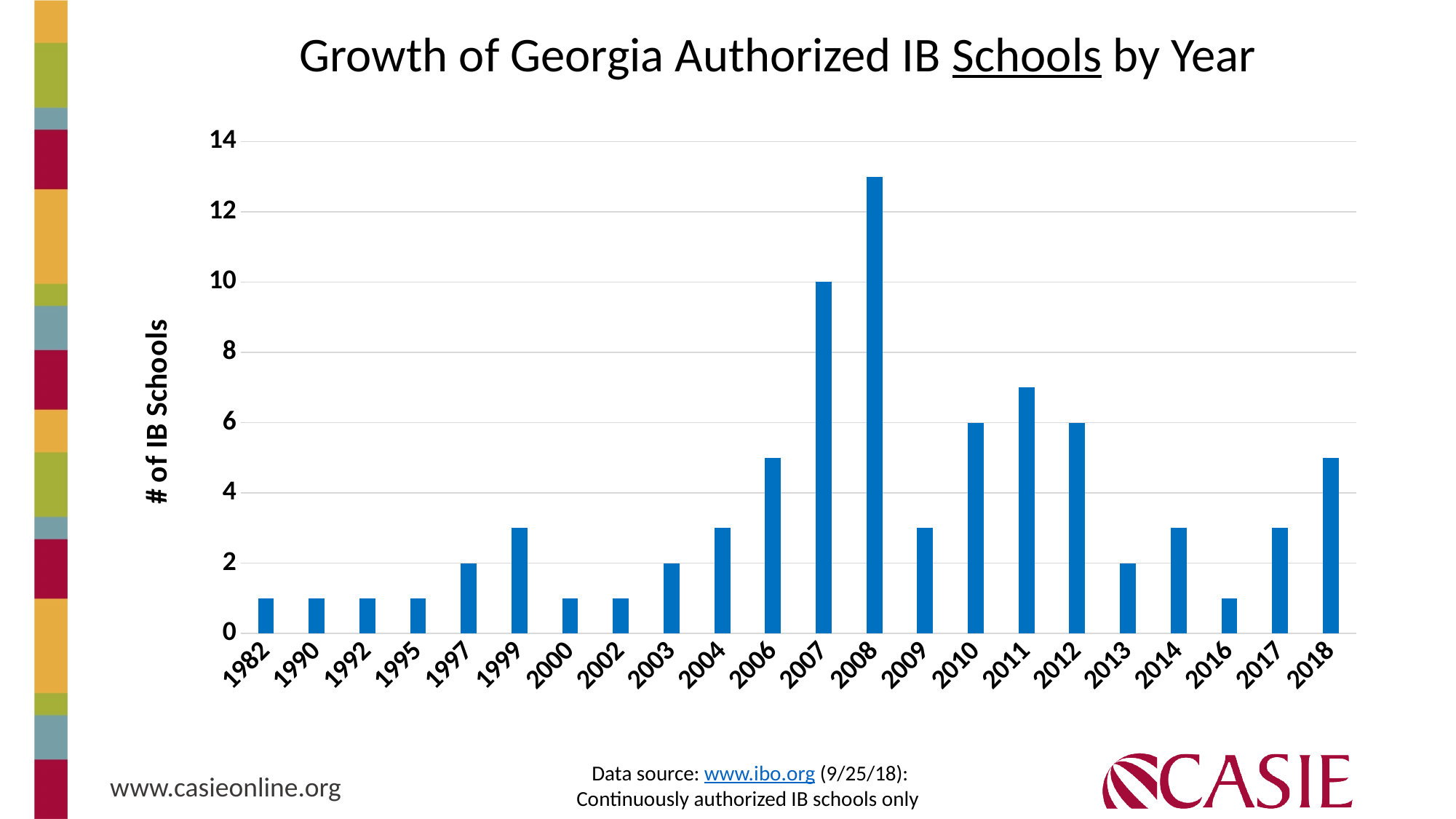
Which year has the highest number of IB schools? 2008 What kind of chart is shown on the slide? bar chart How many IB schools are shown for 2007? 10 What is the difference between the number of IB schools in 2007 and in 2010? 4 How many IB schools are shown for 2010? 6 Is the value for 2011 greater or less than 8? less How many IB schools are shown for 1997? 2 Is the value for 2008 greater or less than 12? greater Which year has more IB schools, 2007 or 2011? 2007 How many years are shown on the x axis of the chart? 22 What is the label on the vertical axis of the chart? # of IB Schools What is the title of the chart? Growth of Georgia Authorized IB Schools by Year